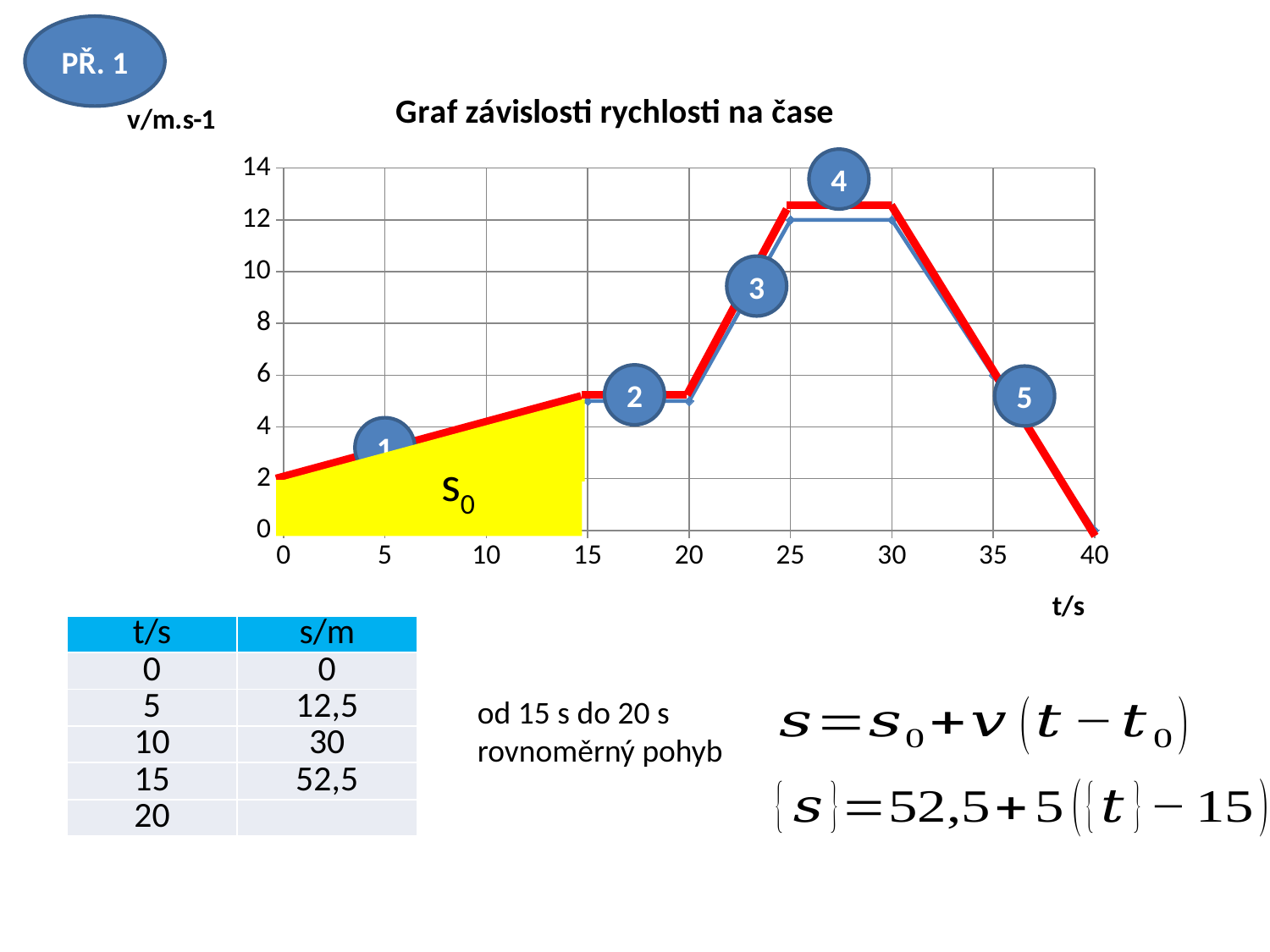
How many numbered circle markers are placed on the line? 5 What is the velocity value at t = 25 s? 12 Does the velocity rise or fall between t = 30 s and t = 40 s? fall What kind of chart is shown on the slide? line chart What is the velocity value at t = 40 s? 0 What is the title of the chart? Graf závislosti rychlosti na čase Which is larger, the velocity at t = 25 s or the velocity at t = 20 s? t = 25 s Is the velocity at t = 15 s greater or less than 6? less What is the difference between the velocity at t = 25 s and the velocity at t = 0 s? 10 What is the velocity value at t = 0 s? 2 What is the highest velocity value reached on the chart? 12 Is the velocity at t = 20 s greater or less than 4? greater